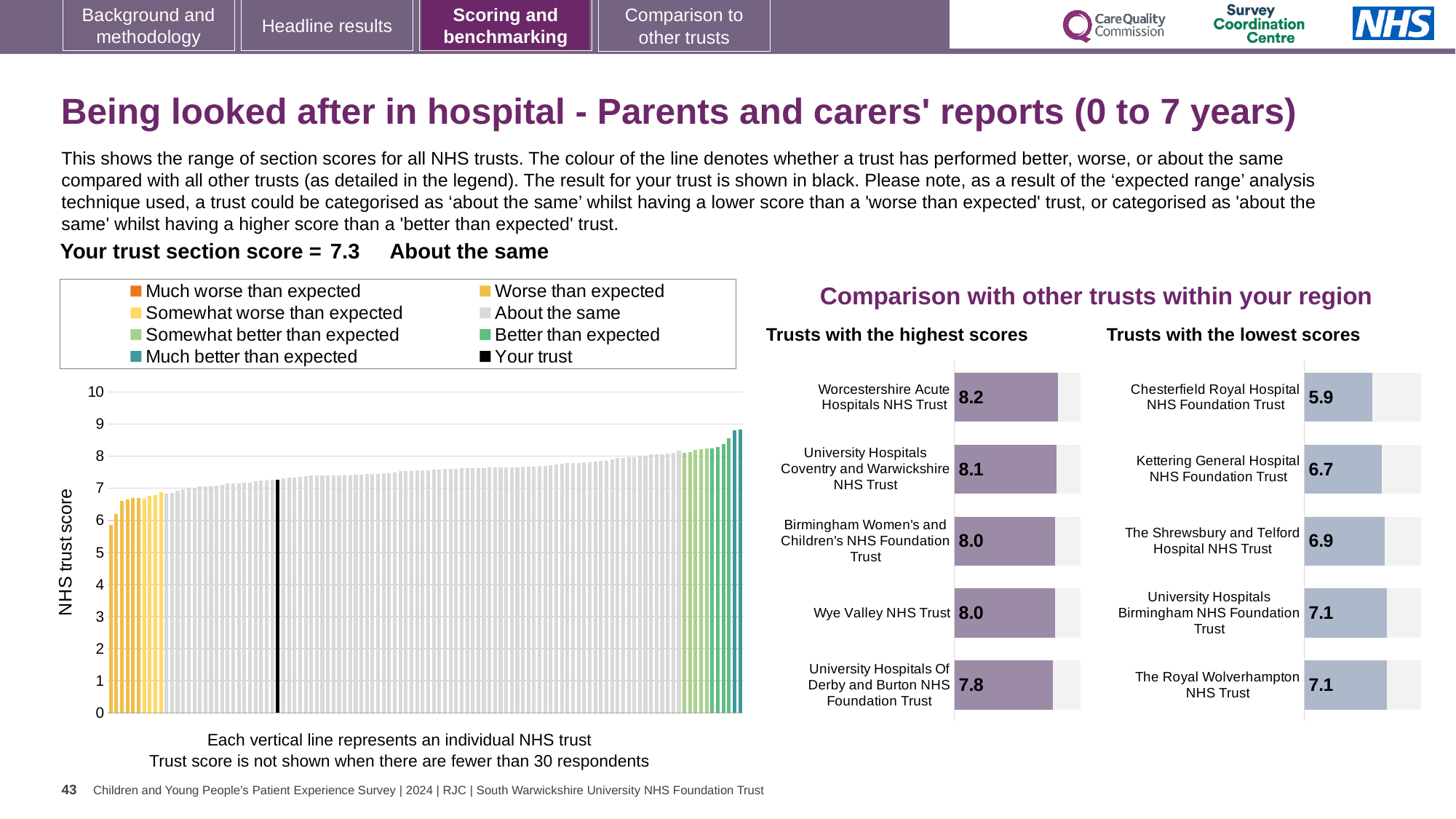
In the 'Trusts with the lowest scores' chart, how much higher is Kettering General Hospital NHS Foundation Trust's score than Chesterfield Royal Hospital NHS Foundation Trust's? 0.8 In the main chart on the left, what is the section score for your trust (the black bar)? 7.3 How many entries does the legend of the main NHS trust score chart on the left list? 8 In the main chart on the left, do the trust scores rise or fall from left to right? Rise How many trusts are listed in the 'Trusts with the lowest scores' chart? 5 In the 'Trusts with the highest scores' chart, which has the larger score: University Hospitals Coventry and Warwickshire NHS Trust or Wye Valley NHS Trust? University Hospitals Coventry and Warwickshire NHS Trust In the 'Trusts with the highest scores' chart, what is the score for Worcestershire Acute Hospitals NHS Trust? 8.2 In the 'Trusts with the highest scores' chart, which trust has the highest score? Worcestershire Acute Hospitals NHS Trust In the 'Trusts with the highest scores' chart, what is the difference between the scores of Worcestershire Acute Hospitals NHS Trust and University Hospitals Of Derby and Burton NHS Foundation Trust? 0.4 What kind of chart is the main chart on the left showing NHS trust scores? Bar chart In the 'Trusts with the lowest scores' chart, which trust has the lowest score? Chesterfield Royal Hospital NHS Foundation Trust In the 'Trusts with the lowest scores' chart, what is the score for Chesterfield Royal Hospital NHS Foundation Trust? 5.9